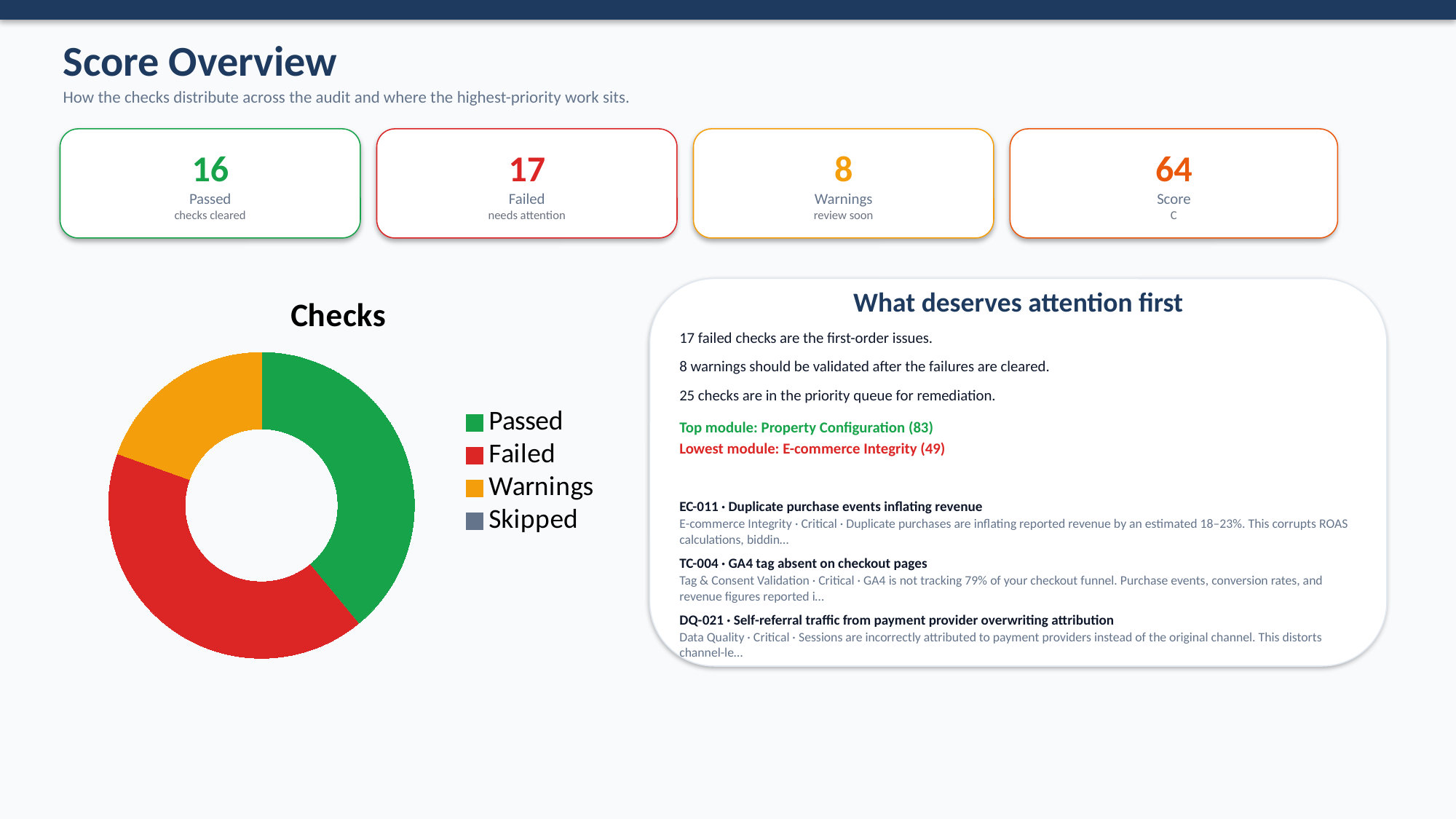
What kind of chart is the "Checks" chart? pie chart (donut) In the "Checks" chart, what colour is the Failed slice? Red What is the difference between the number of Failed checks and the number of Warnings? 9 In the "Checks" chart, which slice is larger, Warnings or Passed? Passed What is the title of the chart on the slide? Checks How many checks are Passed according to the slide? 16 How many checks are Warnings according to the slide? 8 How many entries does the legend of the "Checks" chart list? 4 How many checks are Failed according to the slide? 17 In the "Checks" chart, which slice is larger, Warnings or Failed? Failed What is the difference between the number of Passed checks and the number of Warnings? 8